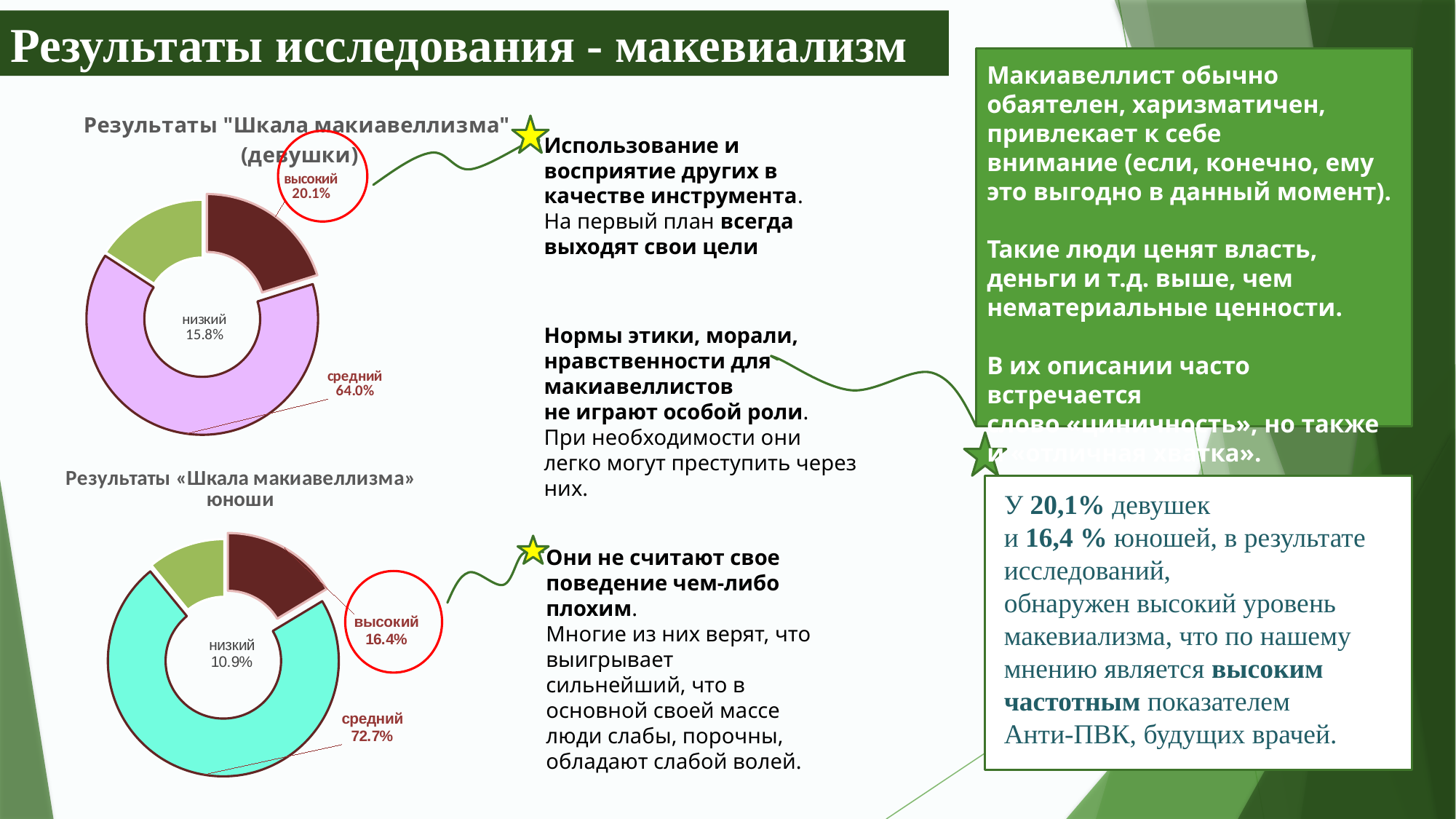
In the bottom chart (юноши), what is the value for the средний category? 72.7% In the top chart (девушки), what is the value for the низкий category? 15.8% Which is larger: the высокий value in the top chart (девушки) or in the bottom chart (юноши)? девушки (20.1%) In the bottom chart (юноши), what is the value for the низкий category? 10.9% What is the difference between the средний values in the bottom chart (юноши) and the top chart (девушки)? 8.7% In the bottom chart (юноши), what is the value for the высокий category? 16.4% What type of chart is the bottom chart (юноши)? Doughnut (pie) chart How many categories does the top chart (девушки) show? 3 In the top chart (девушки), what is the value for the высокий category? 20.1% In the top chart (девушки), which category has the largest share? средний In the bottom chart (юноши), which category has the smallest share? низкий In the top chart (девушки), what is the value for the средний category? 64.0%